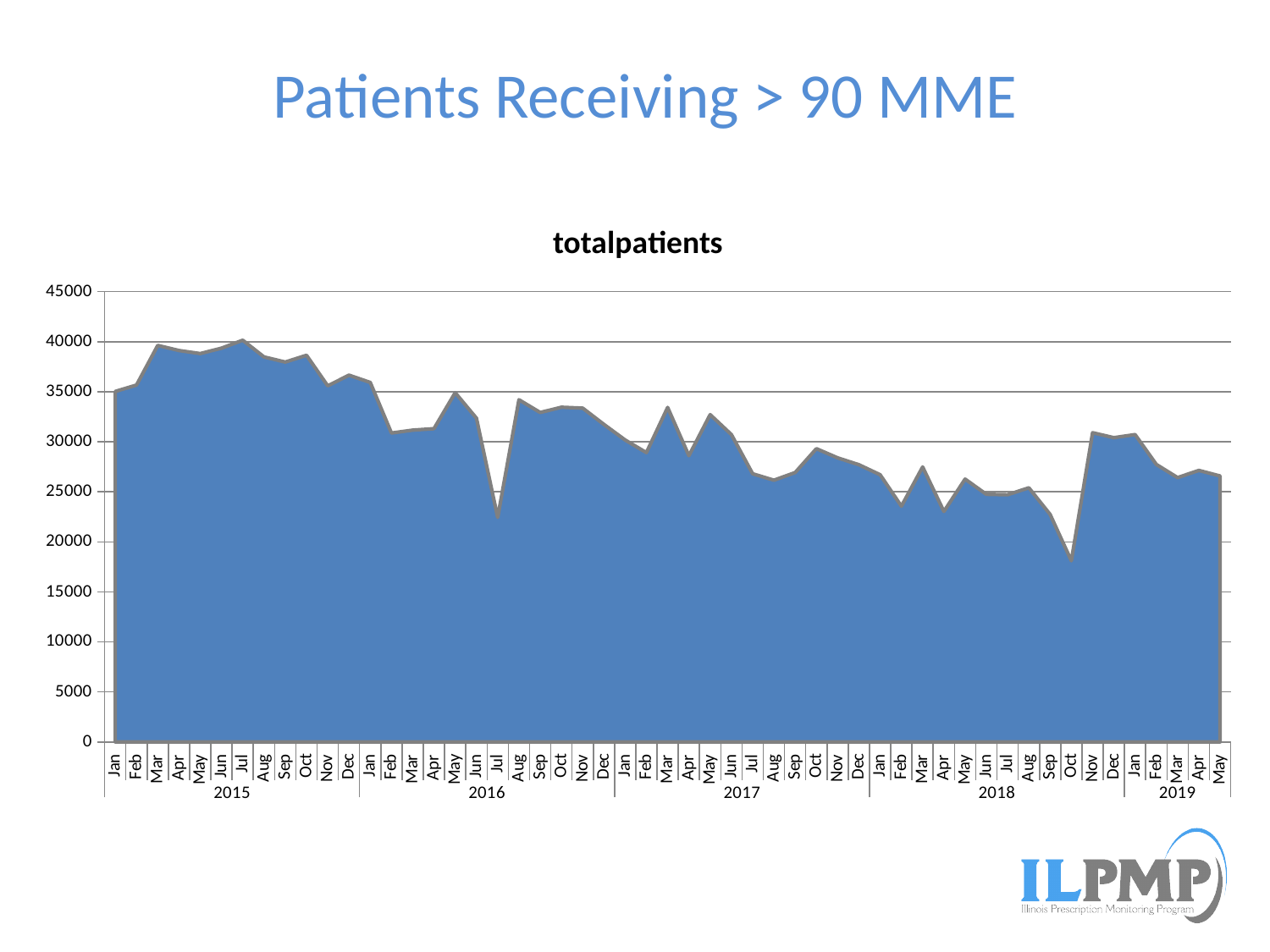
What kind of chart is shown on the slide? area chart Is the value for Jul 2016 greater or less than 25000? less How many monthly data points are plotted from Jan 2015 through May 2019? 53 Which years are labelled along the x axis of the chart? 2015, 2016, 2017, 2018, 2019 Which is larger, the value for Jul 2016 or the value for Oct 2018? Jul 2016 Is the value for May 2019 greater or less than 30000? less What is the title printed above the chart? totalpatients Which is larger, the value for Jul 2015 or the value for Jul 2018? Jul 2015 Which month has the lowest value on the chart? Oct 2018 Is the value for Mar 2015 greater or less than 35000? greater Overall, do the values rise or fall from Jan 2015 to May 2019? fall